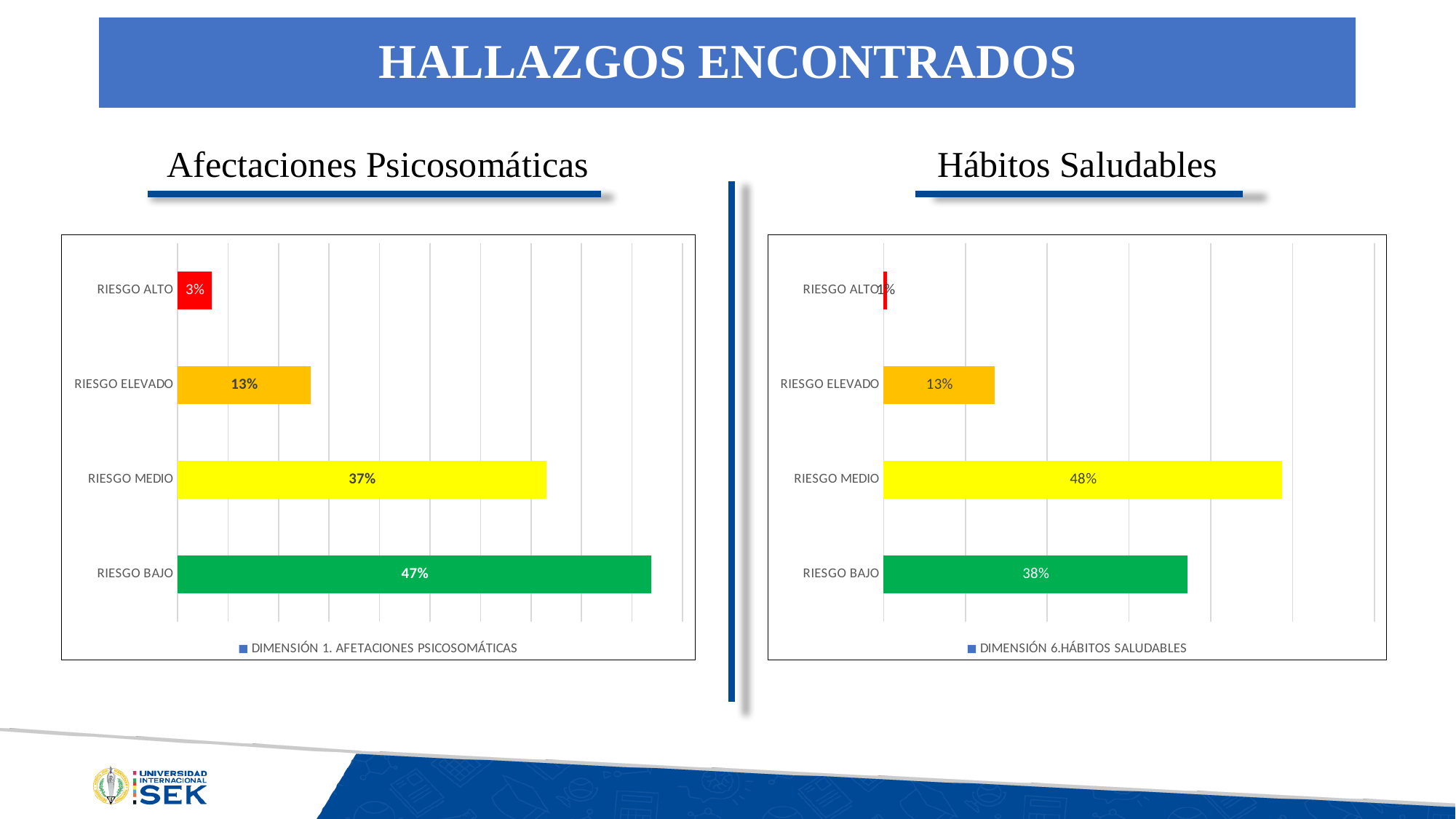
In the Hábitos Saludables chart, which category has the highest value? RIESGO MEDIO In the Afectaciones Psicosomáticas chart, what is the difference between RIESGO BAJO and RIESGO MEDIO? 10% How many categories does the Afectaciones Psicosomáticas chart show? 4 In the Afectaciones Psicosomáticas chart, which category has the lowest value? RIESGO ALTO In the Afectaciones Psicosomáticas chart, what is the value for RIESGO MEDIO? 37% In the Hábitos Saludables chart, what is the difference between RIESGO MEDIO and RIESGO BAJO? 10% In the Afectaciones Psicosomáticas chart, what is the value for RIESGO BAJO? 47% What kind of chart is the Hábitos Saludables chart? Bar chart In the Hábitos Saludables chart, what is the value for RIESGO ELEVADO? 13% In the Hábitos Saludables chart, which is larger, RIESGO BAJO or RIESGO MEDIO? RIESGO MEDIO What is the legend entry of the Afectaciones Psicosomáticas chart? DIMENSIÓN 1. AFETACIONES PSICOSOMÁTICAS In the Hábitos Saludables chart, what is the value for RIESGO MEDIO? 48%